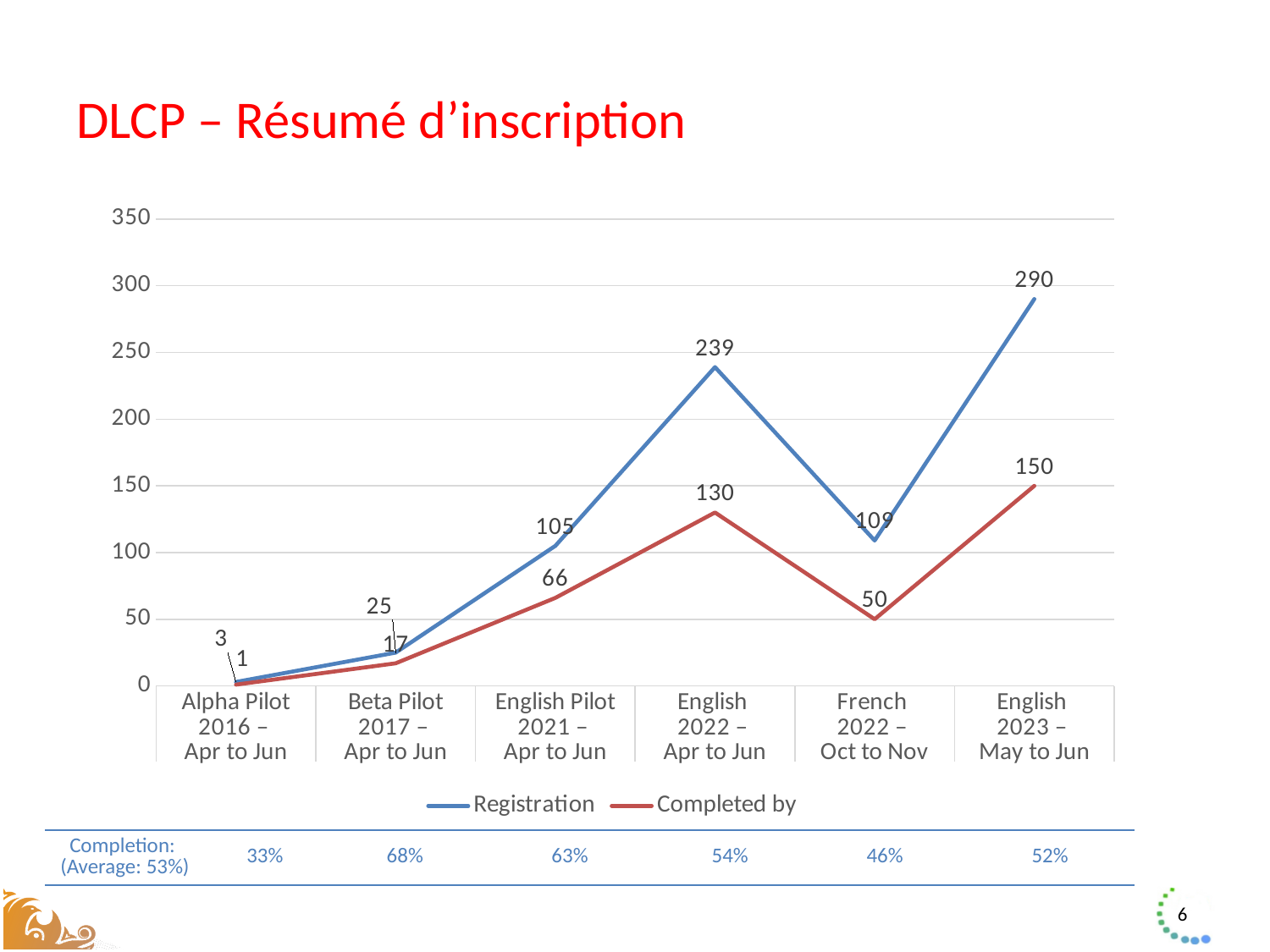
What type of chart is shown on the slide? line chart What is the Registration value for English 2023 – May to Jun? 290 What is the Completed by value for English 2022 – Apr to Jun? 130 Which category has the lowest Completed by value? Alpha Pilot 2016 – Apr to Jun Which is larger: the Registration value for English Pilot 2021 – Apr to Jun or the Registration value for French 2022 – Oct to Nov? French 2022 – Oct to Nov What is the Registration value for French 2022 – Oct to Nov? 109 Which category has the highest Registration value? English 2023 – May to Jun Does the Registration series rise or fall from English 2022 – Apr to Jun to French 2022 – Oct to Nov? fall What is the difference between Registration and Completed by for English 2022 – Apr to Jun? 109 What colour is the Completed by line? red How many categories are shown on the x axis? 6 How many series does the legend list? 2